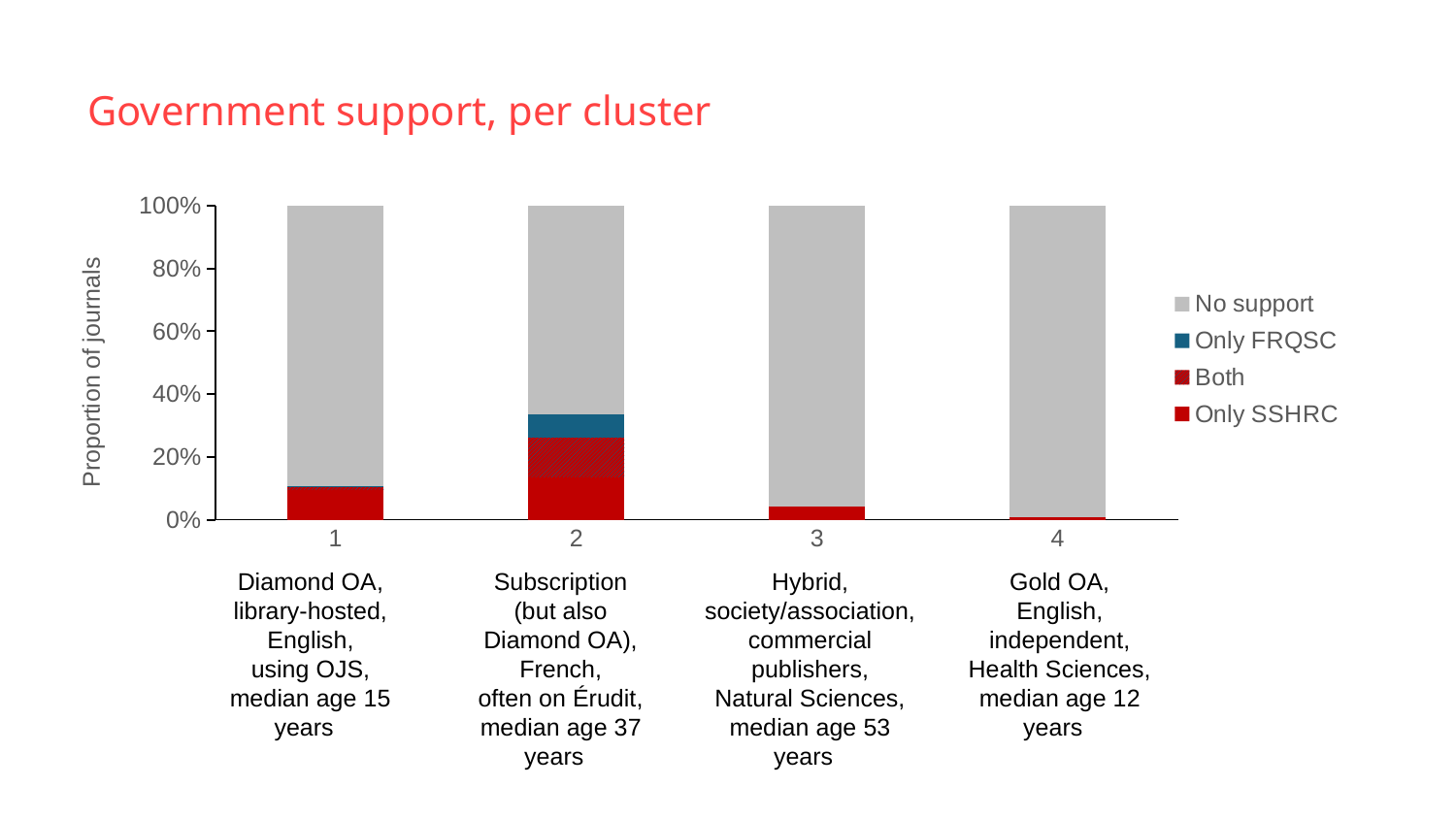
Is the 'No support' share for cluster 2 greater or less than 80%? less What is the title of the chart? Government support, per cluster How many clusters are plotted along the x axis? 4 Which cluster has a larger 'Only SSHRC' share, cluster 3 or cluster 4? 3 What kind of chart is shown on the slide? Stacked bar chart Which cluster has the largest 'Only SSHRC' share? 2 How many series does the legend list? 4 What is the label of the y axis? Proportion of journals Is the 'No support' share for cluster 1 greater or less than 80%? greater Which cluster is the only one with an 'Only FRQSC' segment? 2 What is the total height of the stacked bar for cluster 1? 100% Which cluster has the smallest 'Only SSHRC' share? 4